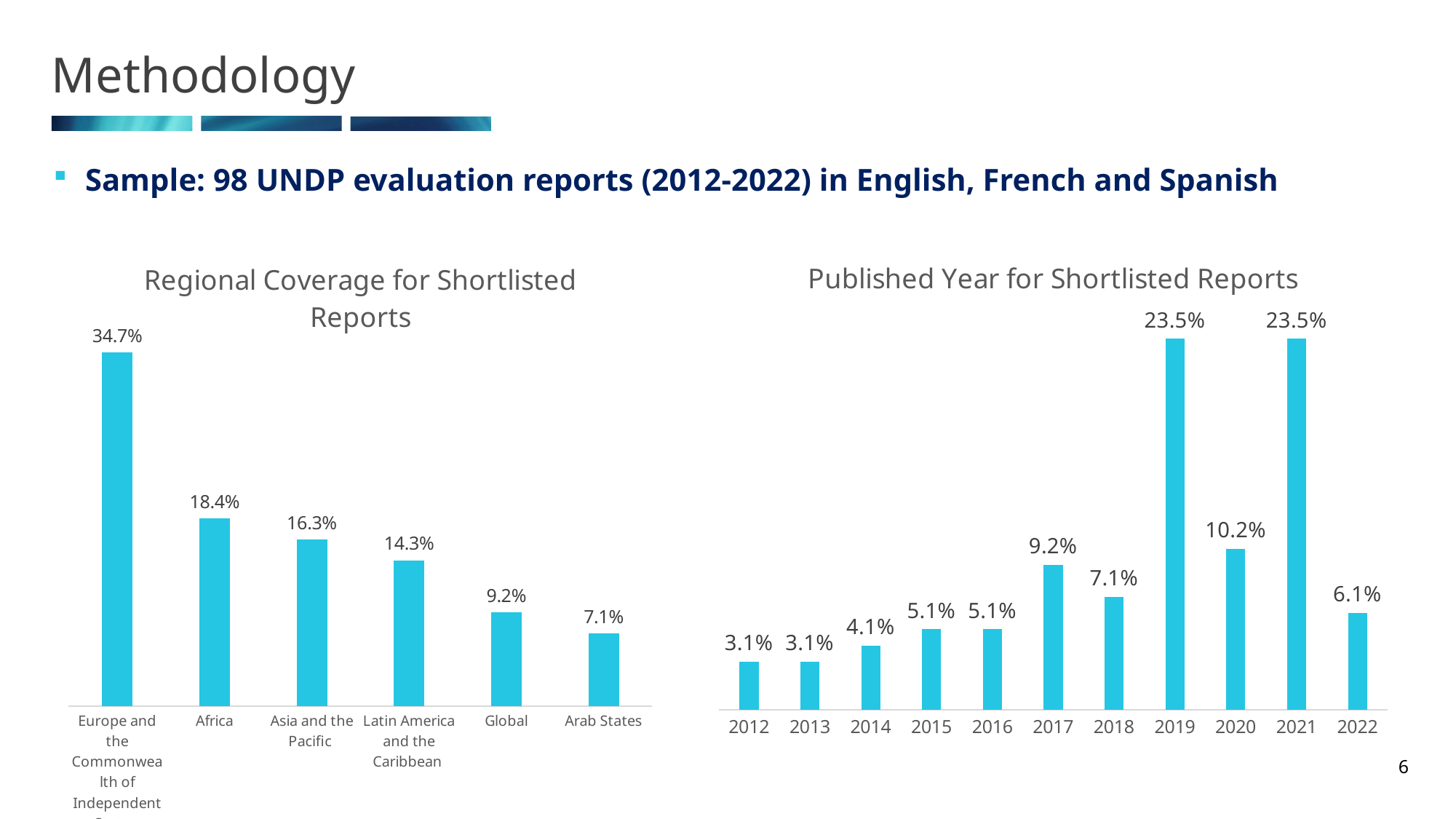
In the 'Published Year for Shortlisted Reports' chart, what is the difference between 2019 and 2020? 13.3% In the 'Published Year for Shortlisted Reports' chart, how many years are shown? 11 In the 'Published Year for Shortlisted Reports' chart, what is the value for 2020? 10.2% In the 'Regional Coverage for Shortlisted Reports' chart, what is the difference between Asia and the Pacific and Latin America and the Caribbean? 2.0% In the 'Regional Coverage for Shortlisted Reports' chart, what is the value for Africa? 18.4% In the 'Published Year for Shortlisted Reports' chart, which years share the highest value? 2019 and 2021 In the 'Published Year for Shortlisted Reports' chart, do the values rise or fall from 2012 to 2017? rise In the 'Regional Coverage for Shortlisted Reports' chart, which region has the lowest value? Arab States What type of chart is the 'Published Year for Shortlisted Reports' chart? bar chart In the 'Regional Coverage for Shortlisted Reports' chart, how many regions are shown? 6 In the 'Regional Coverage for Shortlisted Reports' chart, which is larger, Global or Arab States? Global In the 'Published Year for Shortlisted Reports' chart, what is the value for 2017? 9.2%